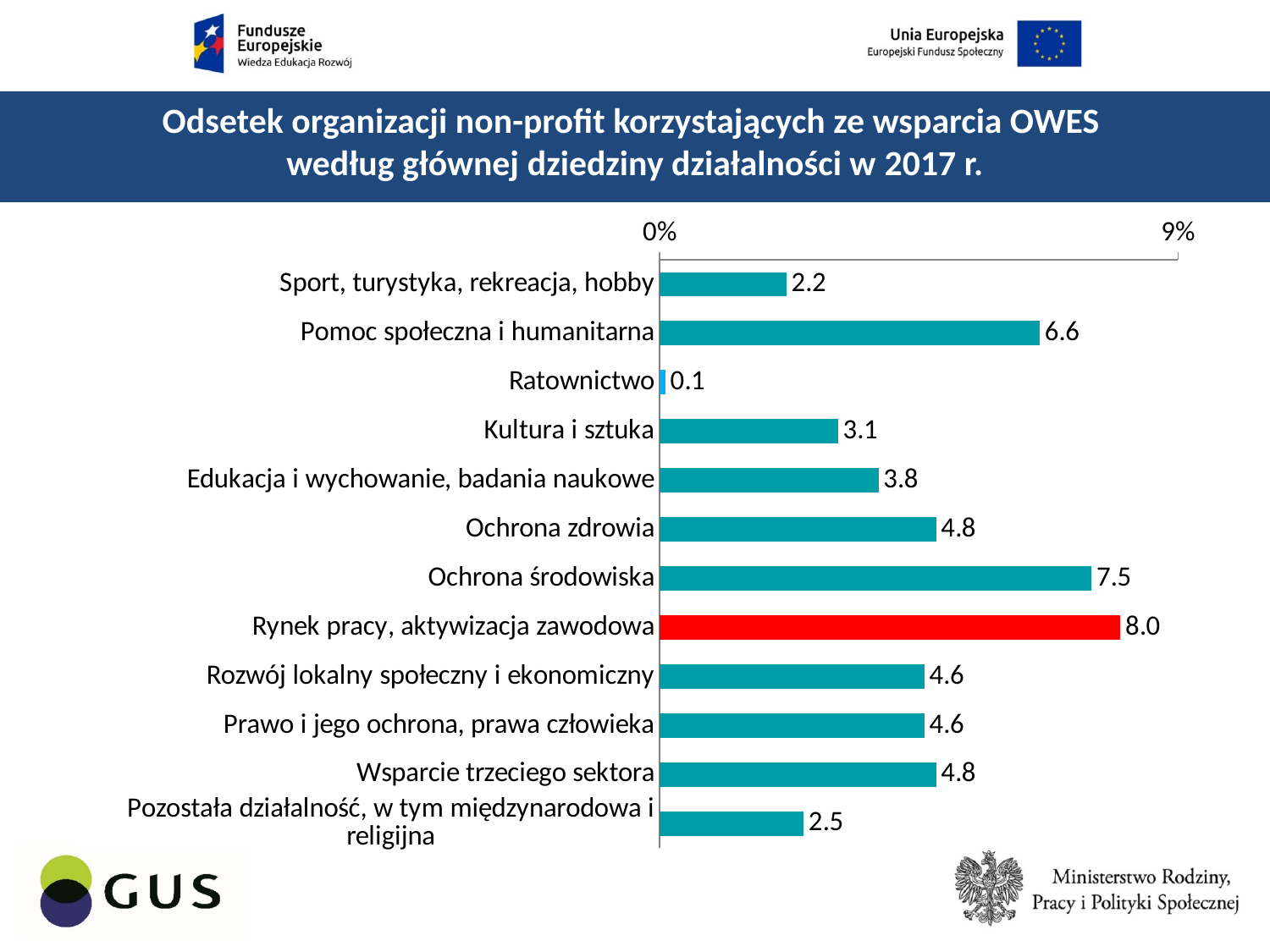
What is the difference between the values for Ochrona środowiska and Pomoc społeczna i humanitarna? 0.9 What is the value for Ratownictwo? 0.1 Which category has the highest value? Rynek pracy, aktywizacja zawodowa What is the value for Pomoc społeczna i humanitarna? 6.6 Which category's bar is highlighted in red? Rynek pracy, aktywizacja zawodowa What is the value for Ochrona środowiska? 7.5 Which category has the lowest value? Ratownictwo How many categories are shown in the chart? 12 What kind of chart is shown on the slide? Bar chart Which is larger, the value for Kultura i sztuka or the value for Ochrona zdrowia? Ochrona zdrowia What is the difference between the values for Rynek pracy, aktywizacja zawodowa and Sport, turystyka, rekreacja, hobby? 5.8 What is the value for Edukacja i wychowanie, badania naukowe? 3.8